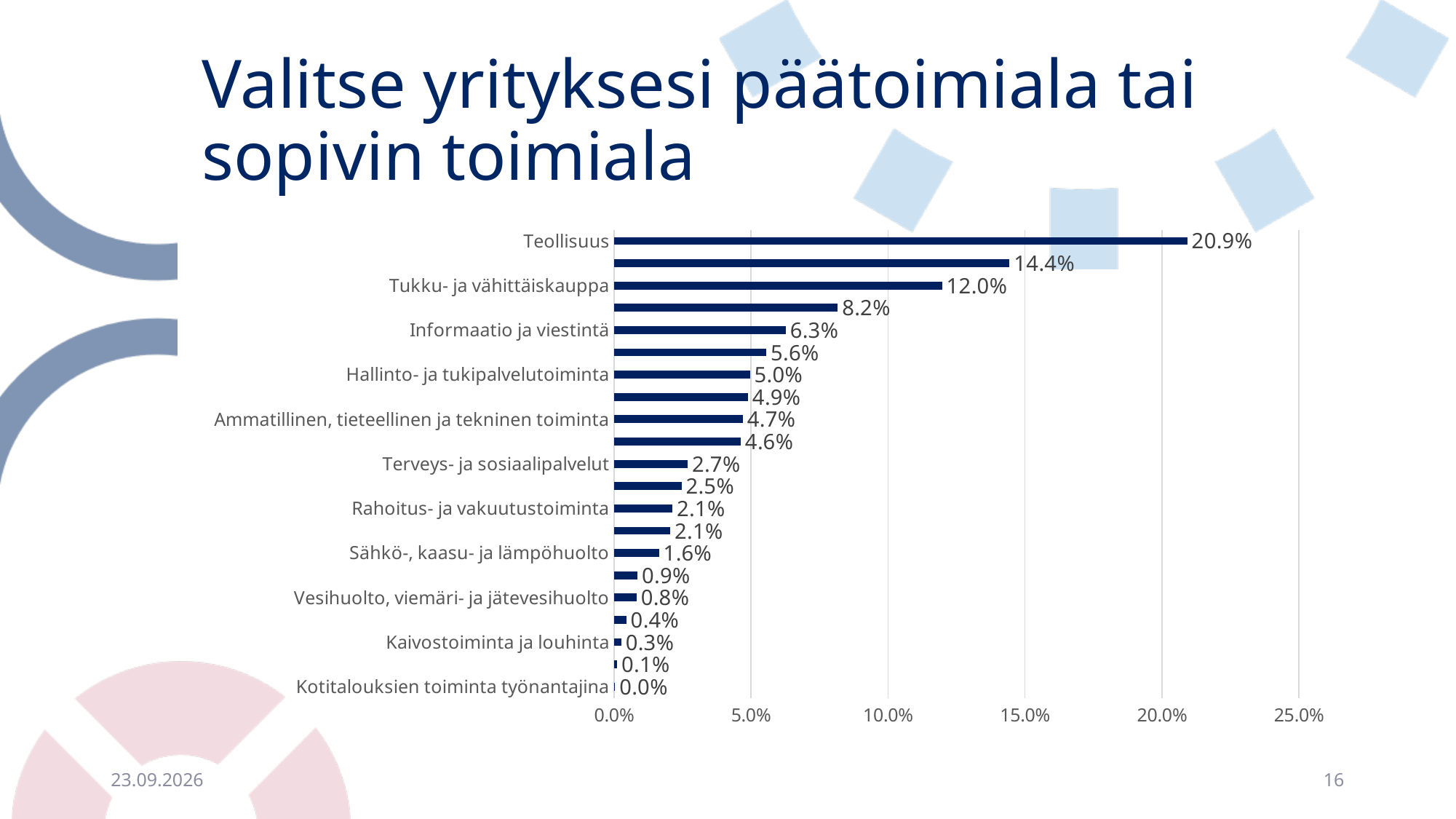
What is the value for Kaivostoiminta ja louhinta? 0.3% Which is larger, the value for Informaatio ja viestintä or the value for Hallinto- ja tukipalvelutoiminta? Informaatio ja viestintä Which category has the lowest value? Kotitalouksien toiminta työnantajina How many bars are plotted in the chart? 21 Which category has the highest value? Teollisuus What is the value for Tukku- ja vähittäiskauppa? 12.0% What is the value for Terveys- ja sosiaalipalvelut? 2.7% What is the difference between the values for Teollisuus and Tukku- ja vähittäiskauppa? 8.9 percentage points What kind of chart is shown on the slide? bar chart What is the value for Teollisuus? 20.9% What is the value for Informaatio ja viestintä? 6.3% Is the value for Teollisuus greater or less than 20.0%? greater